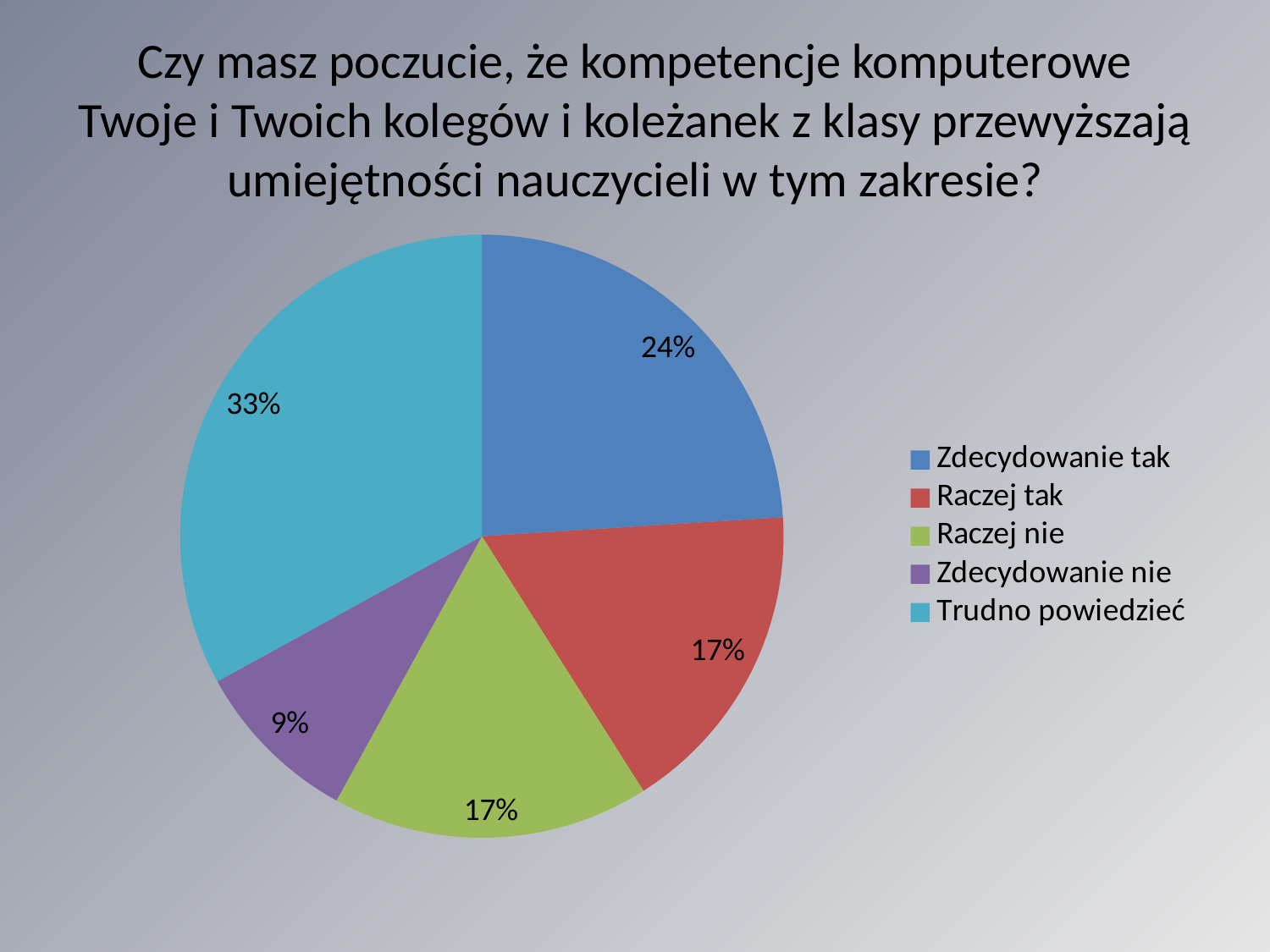
What percentage of respondents answered "Zdecydowanie nie"? 9% What is the difference in percentage points between "Trudno powiedzieć" and "Zdecydowanie tak"? 9 What percentage of respondents answered "Zdecydowanie tak"? 24% Which answer category has the largest share of the pie? Trudno powiedzieć Which answer category has the smallest share of the pie? Zdecydowanie nie What colour is the slice for "Raczej nie"? green What is the difference in percentage points between "Zdecydowanie tak" and "Zdecydowanie nie"? 15 What kind of chart is shown on the slide? pie chart How many answer categories does the legend list? 5 What percentage of respondents answered "Raczej tak"? 17% Which is larger, the share for "Zdecydowanie tak" or the share for "Raczej nie"? Zdecydowanie tak What percentage of respondents answered "Trudno powiedzieć"? 33%